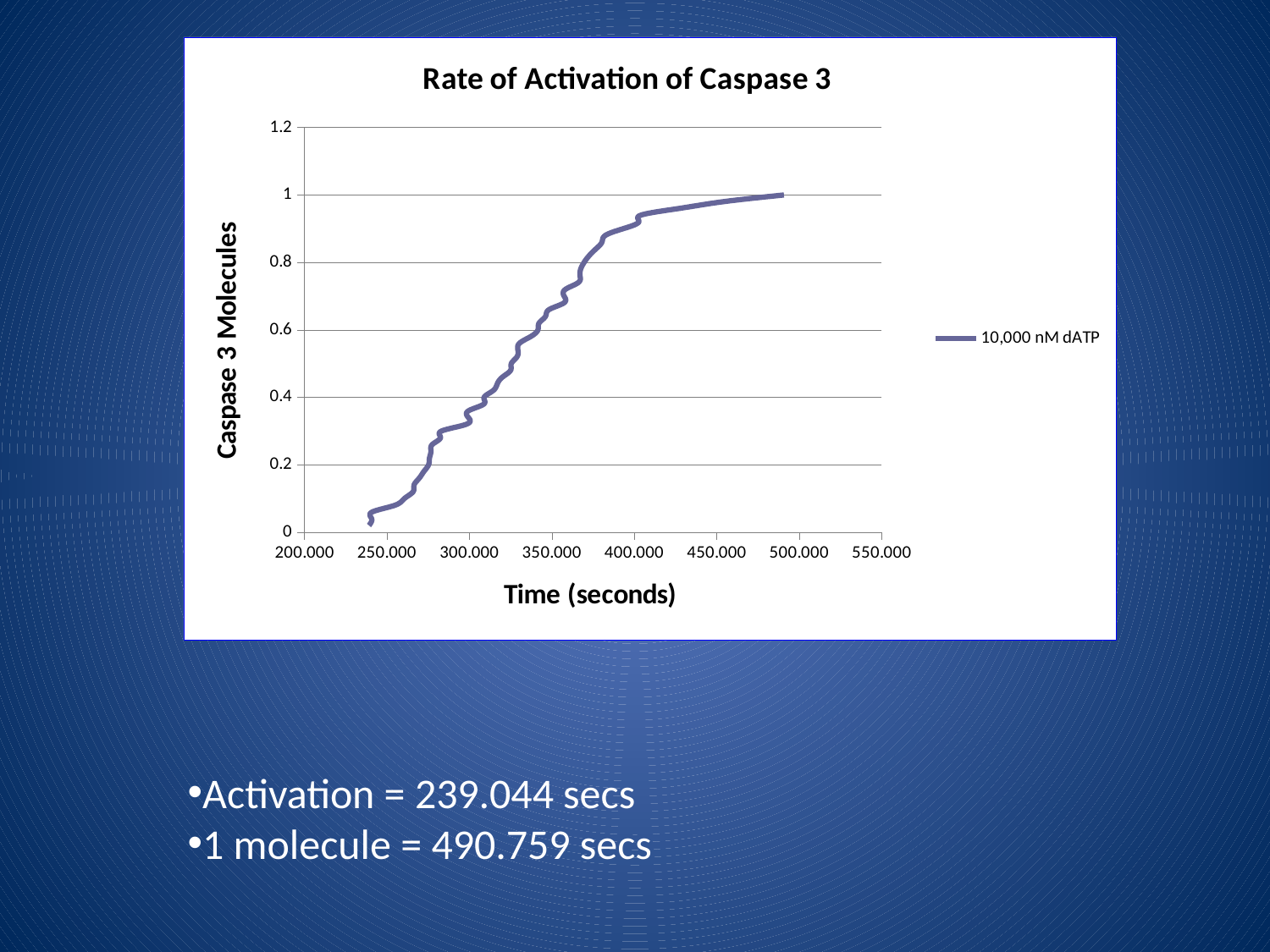
Is the value for 10,000 nM dATP at 400.000 seconds greater or less than 0.8? greater Is the value for 10,000 nM dATP at 450.000 seconds greater or less than 0.8? greater What is the title of the chart? Rate of Activation of Caspase 3 What kind of chart is shown on the slide? line chart How many series does the legend list? 1 Is the value for 10,000 nM dATP at 300.000 seconds greater or less than 0.4? less What is the name of the series shown in the legend? 10,000 nM dATP What is the highest value of Caspase 3 Molecules reached by the line? 1 Do the values rise or fall as time increases along the x axis? rise